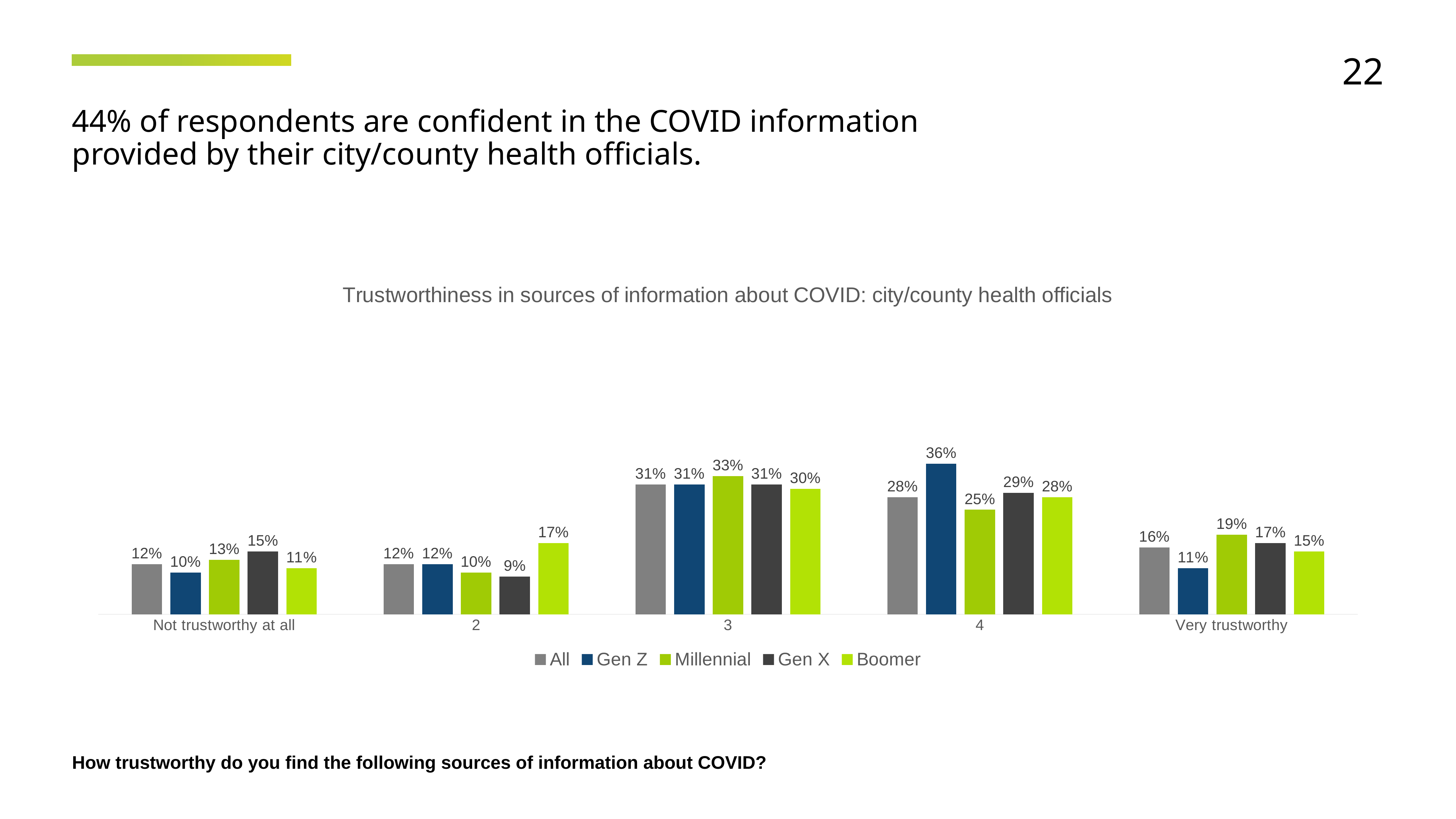
How many categories are shown on the x axis? 5 What is the value for Gen Z in the '4' category? 36% Which series has the lowest value in the '2' category? Gen X What kind of chart is shown on the slide? Bar chart How many series does the legend list? 5 What is the value for Gen X in the 'Not trustworthy at all' category? 15% What is the difference between the Gen Z and Millennial values in the '4' category? 11% Which is larger in the 'Very trustworthy' category: the value for All or the value for Gen Z? All What is the value for Boomer in the '2' category? 17% What is the title of the chart? Trustworthiness in sources of information about COVID: city/county health officials What is the value for Millennial in the 'Very trustworthy' category? 19% Which series has the highest value in the '4' category? Gen Z